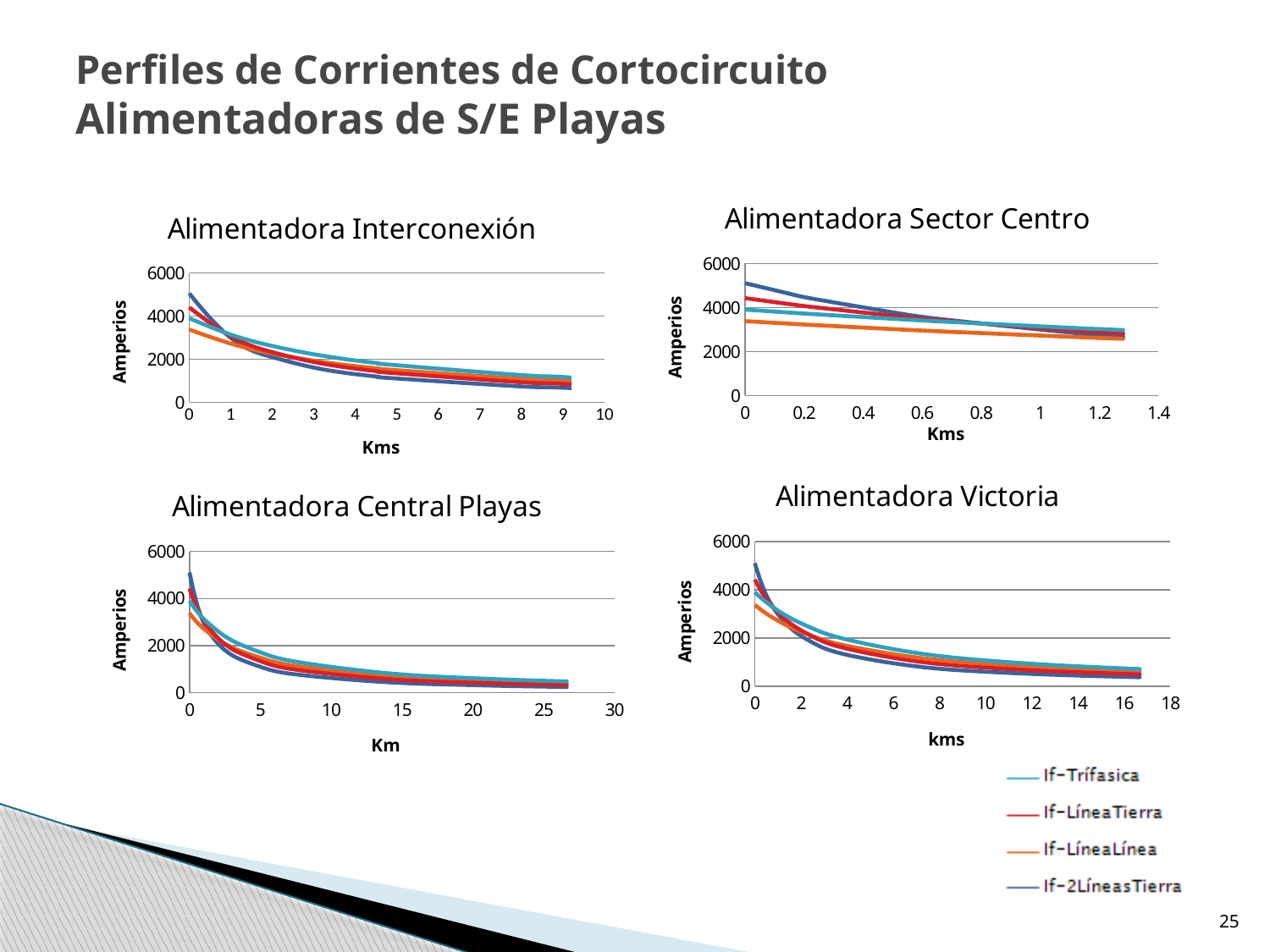
In the "Alimentadora Sector Centro" chart, is the value of If-2LíneasTierra at 0 km greater or less than 4000? greater How many charts are shown on the slide? 4 How many series does the legend at the bottom right of the slide list? 4 In the "Alimentadora Interconexión" chart, is the value of If-2LíneasTierra at 0 km greater or less than 4000? greater In the "Alimentadora Sector Centro" chart, which series has the lowest value at 0 km? If-LíneaLínea In the "Alimentadora Central Playas" chart, do the currents rise or fall along the x axis? fall In the "Alimentadora Sector Centro" chart, do the values rise or fall as Kms increases? fall What is the y-axis label of the "Alimentadora Victoria" chart? Amperios What kind of chart is "Alimentadora Interconexión"? line chart In the "Alimentadora Sector Centro" chart, is the value of If-LíneaLínea at 0 km greater or less than 4000? less In the "Alimentadora Sector Centro" chart, which series has the highest value at 0 km? If-2LíneasTierra